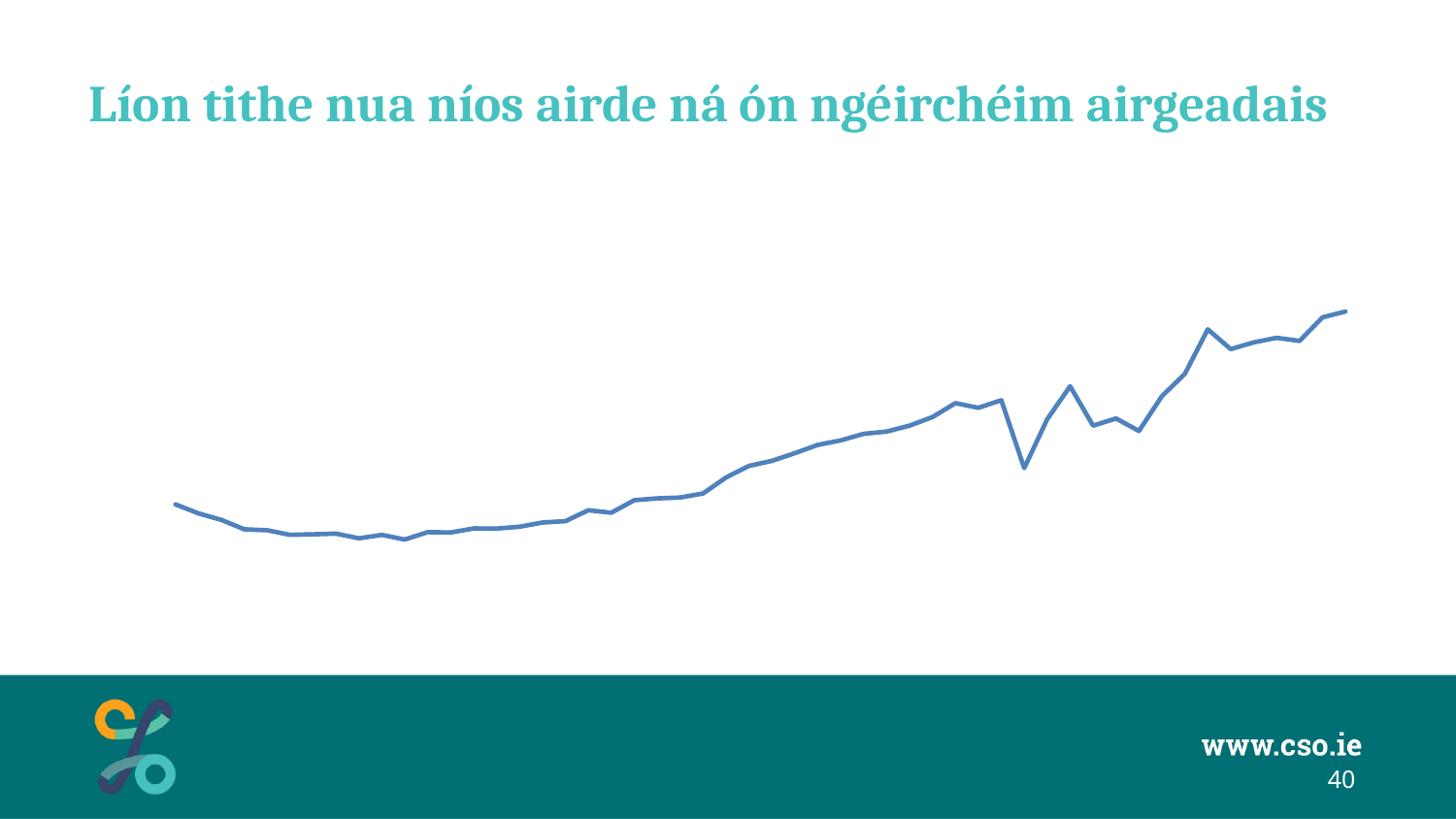
What colour is the line in the chart? Blue What is the title of the slide containing the chart? Líon tithe nua níos airde ná ón ngéirchéim airgeadais What kind of chart is shown on the slide? Line chart Do the values in the line chart generally rise or fall from left to right? Rise How many lines are plotted in the chart? 1